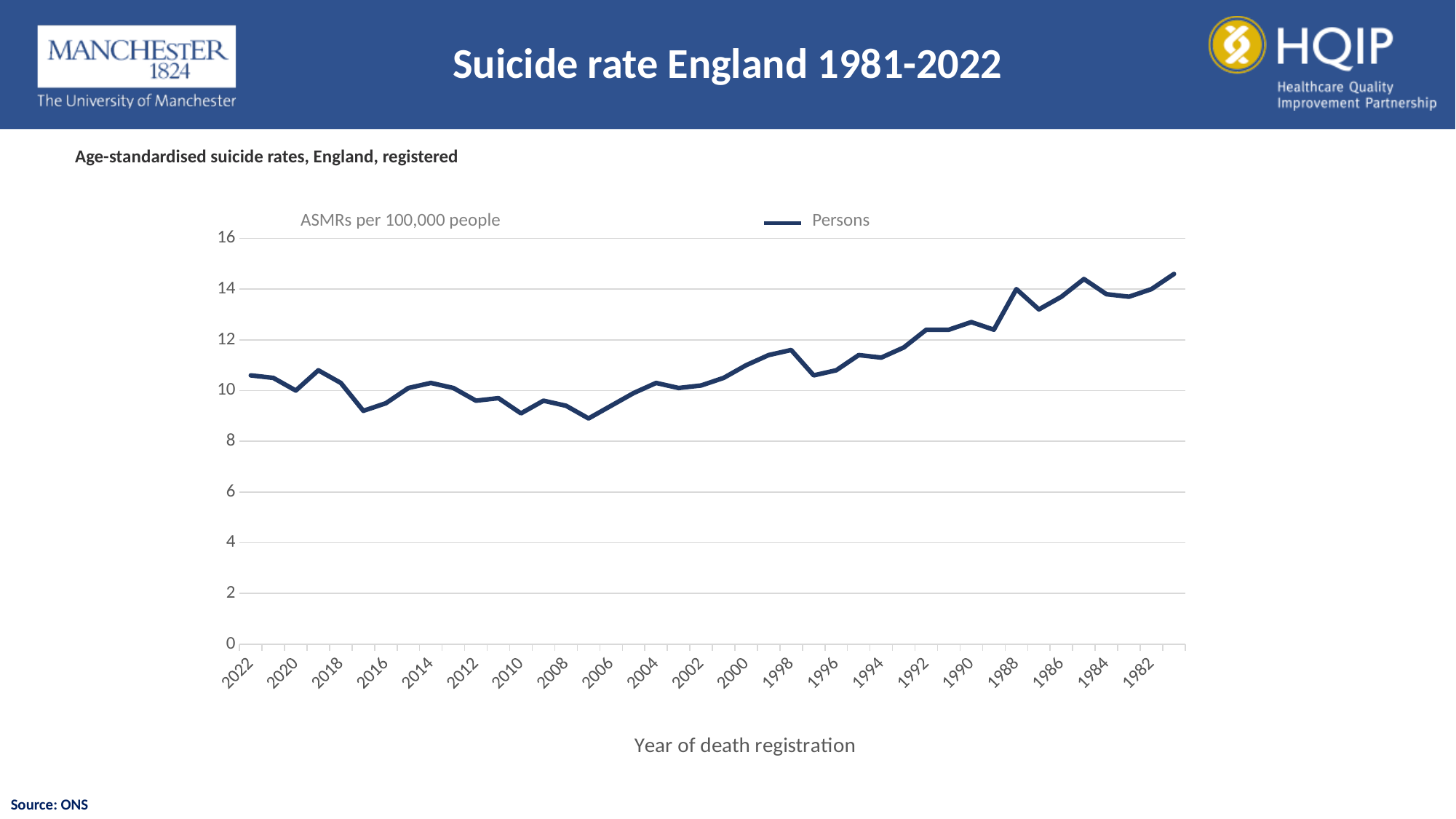
What kind of chart is shown on the slide? line chart What is the name of the series shown in the legend? Persons Is the value for 1990 greater or less than 12? greater Is the value for 1981 greater or less than 14? greater Reading the x axis from left (2022) to right (1981), do the values generally rise or fall? rise Is the value for 2007 greater or less than 10? less What is the title of the x axis? Year of death registration How many series does the chart legend list? 1 Which year has the larger value, 1981 or 2022? 1981